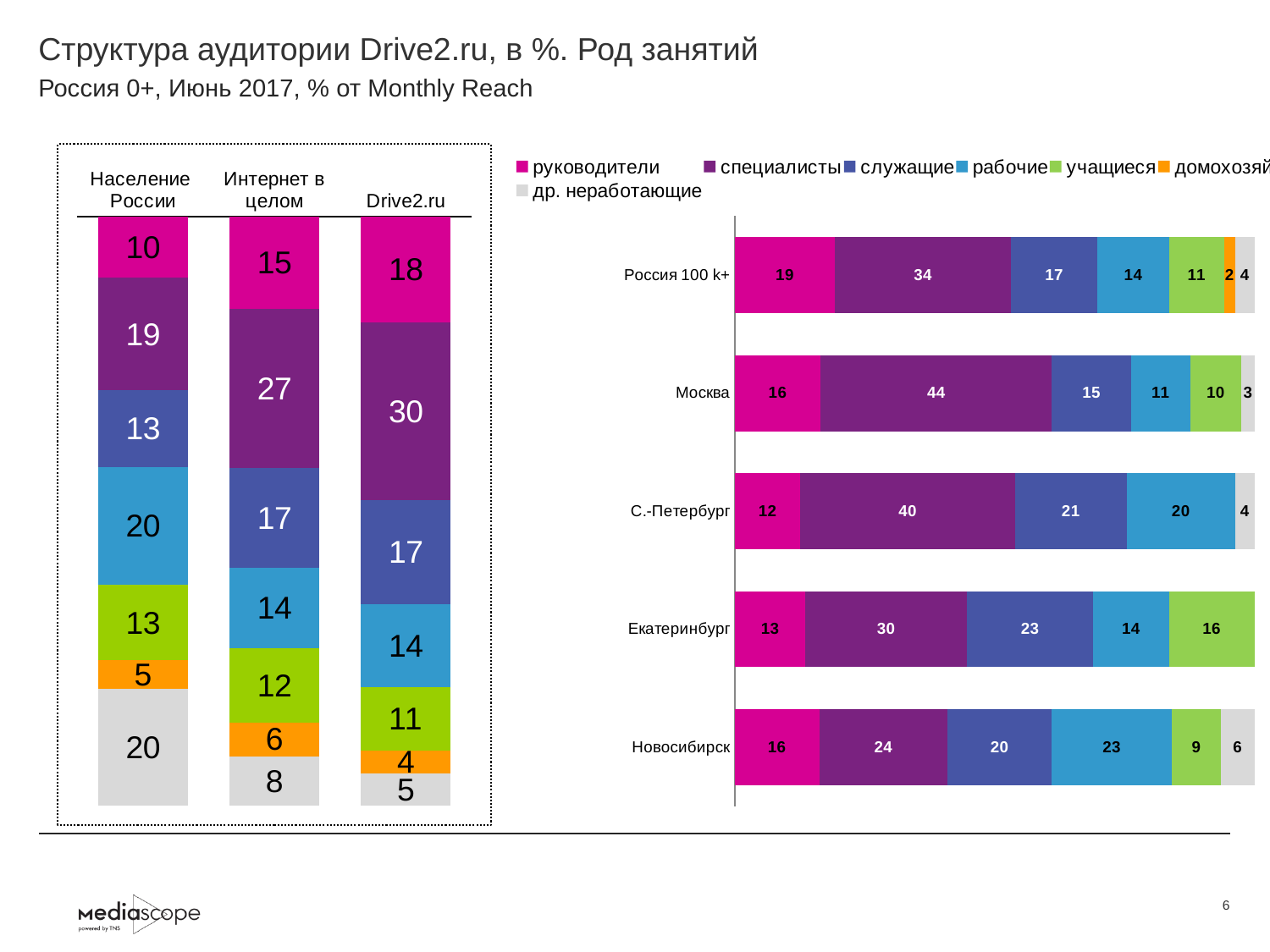
In the left chart, what is the value for рабочие in the Население России bar? 20 What kind of chart is the right chart? Stacked bar chart In the left chart, what is the difference between the руководители values for Drive2.ru and Население России? 8 In the right chart, which is larger: the рабочие value for Новосибирск or for Москва? Новосибирск How many series does the legend of the right chart list? 7 In the right chart, which row has the lowest value for руководители? С.-Петербург In the right chart, which city has the highest value for специалисты? Москва In the right chart, what is the value for служащие for Екатеринбург? 23 How many bars (categories) does the left chart show? 3 In the right chart, what is the value for специалисты for Москва? 44 In the right chart, what is the total of the Новосибирск bar? 98 In the left chart, what is the value for специалисты in the Drive2.ru bar? 30